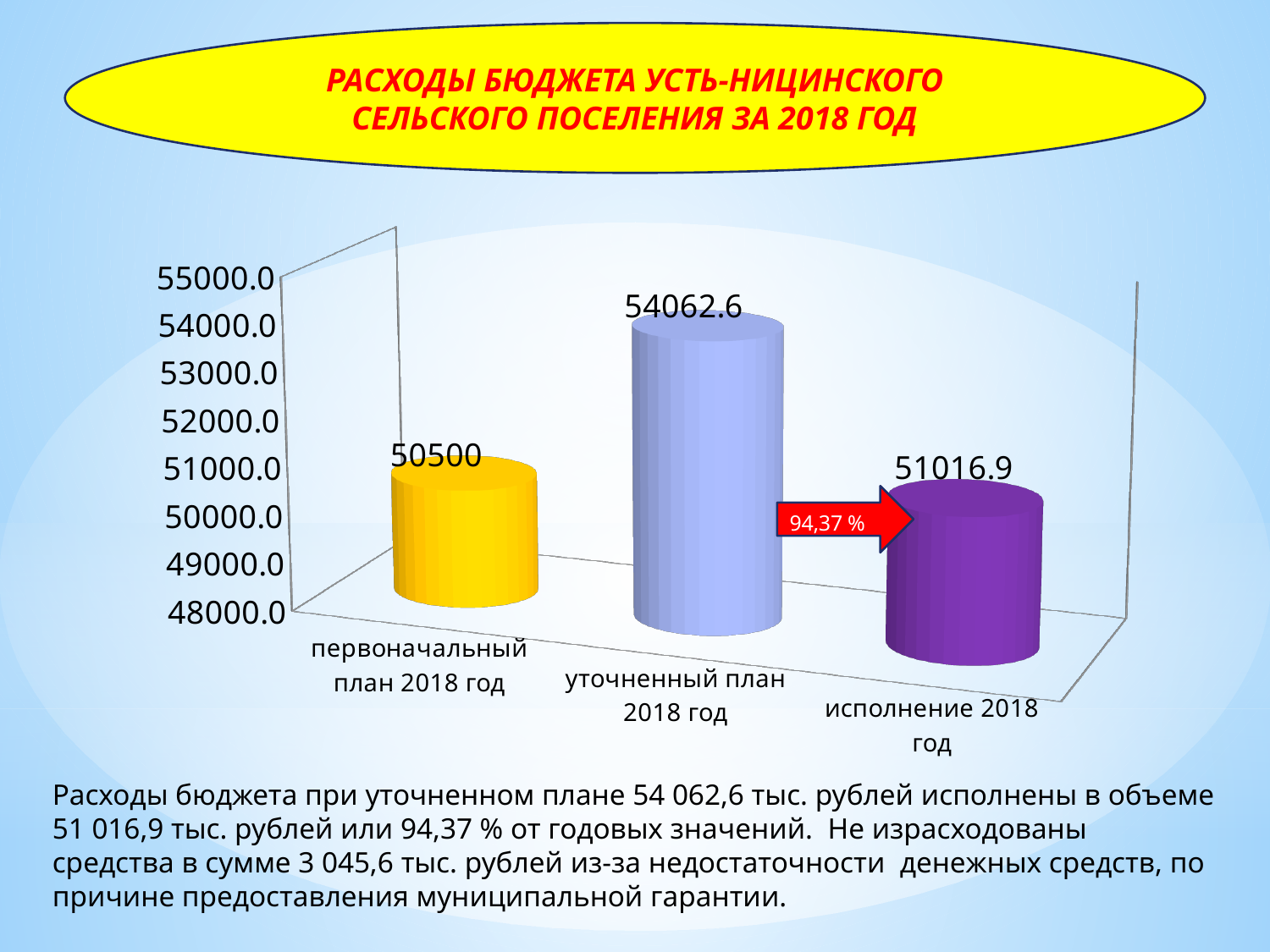
What is the value for уточненный план 2018 год? 54062.6 What is the difference between исполнение 2018 год and первоначальный план 2018 год? 516.9 Which category has the highest value? уточненный план 2018 год Which category has the lowest value? первоначальный план 2018 год What kind of chart is shown on the slide? bar chart What is the value for первоначальный план 2018 год? 50500 What percentage is shown on the red arrow between the second and third bars? 94,37 % What is the difference between уточненный план 2018 год and первоначальный план 2018 год? 3562.6 Is the value for исполнение 2018 год greater or less than 52000.0? less What is the value for исполнение 2018 год? 51016.9 Which is larger, исполнение 2018 год or первоначальный план 2018 год? исполнение 2018 год How many categories are shown on the chart? 3